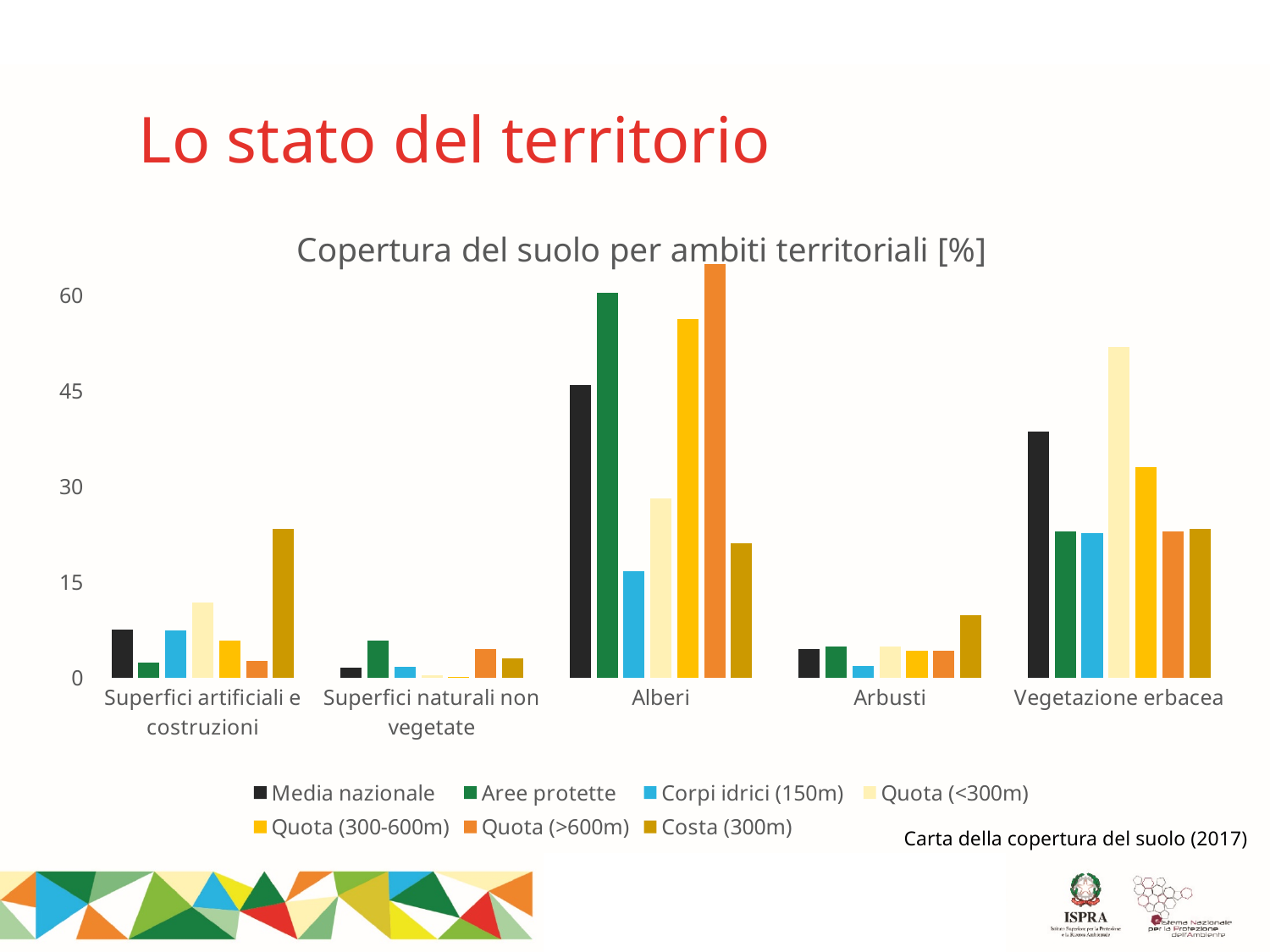
Which series has the highest value in the Alberi category? Quota (>600m) Is the value for Aree protette in the Alberi category greater or less than 45? greater What kind of chart is shown on the slide? bar chart Is the value for Costa (300m) in the Arbusti category greater or less than 15? less Which series has the highest value in the Vegetazione erbacea category? Quota (<300m) How many series does the legend list? 7 What is the title of the chart? Copertura del suolo per ambiti territoriali [%] Which series has the lowest value in the Alberi category? Corpi idrici (150m) Which series has the highest value in the Superfici artificiali e costruzioni category? Costa (300m) In the Alberi category, which is larger: Aree protette or Quota (<300m)? Aree protette How many categories are shown on the x axis of the chart? 5